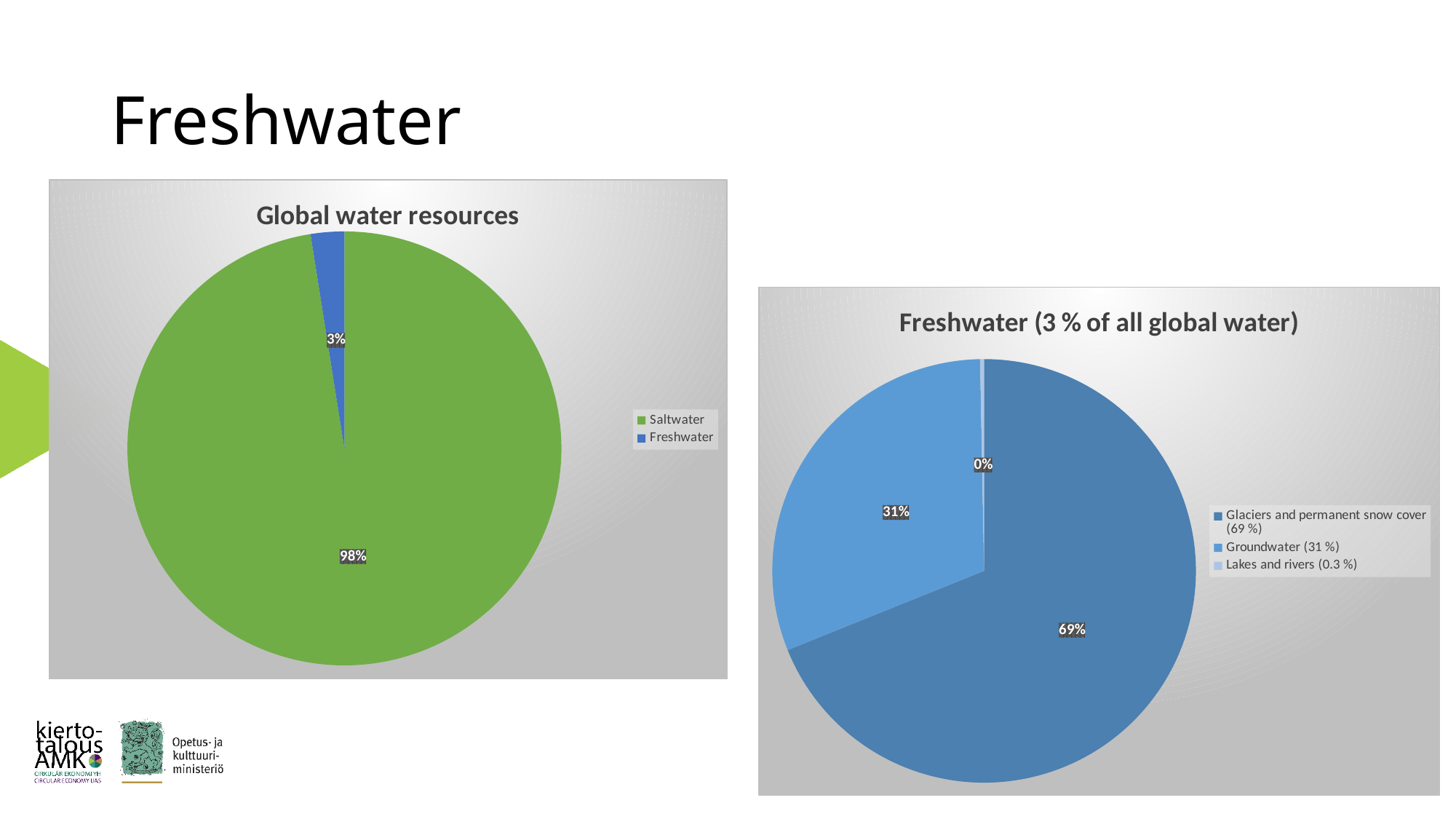
In the 'Freshwater (3 % of all global water)' chart, what share of the pie is Glaciers and permanent snow cover? 69% In the 'Global water resources' chart, how many categories does the legend list? 2 In the 'Freshwater (3 % of all global water)' chart, what is the difference between the Glaciers and permanent snow cover share and the Groundwater share? 38% In the 'Global water resources' chart, what share of the pie is Freshwater? 3% In the 'Freshwater (3 % of all global water)' chart, how many categories does the legend list? 3 In the 'Freshwater (3 % of all global water)' chart, which category is the smallest? Lakes and rivers In the 'Freshwater (3 % of all global water)' chart, what share of the pie is Groundwater? 31% In the 'Global water resources' chart, which category is the largest? Saltwater In the 'Freshwater (3 % of all global water)' chart, what data label is shown for Lakes and rivers? 0% In the 'Freshwater (3 % of all global water)' chart, which is larger, Glaciers and permanent snow cover or Groundwater? Glaciers and permanent snow cover What kind of chart is the 'Global water resources' chart? Pie chart